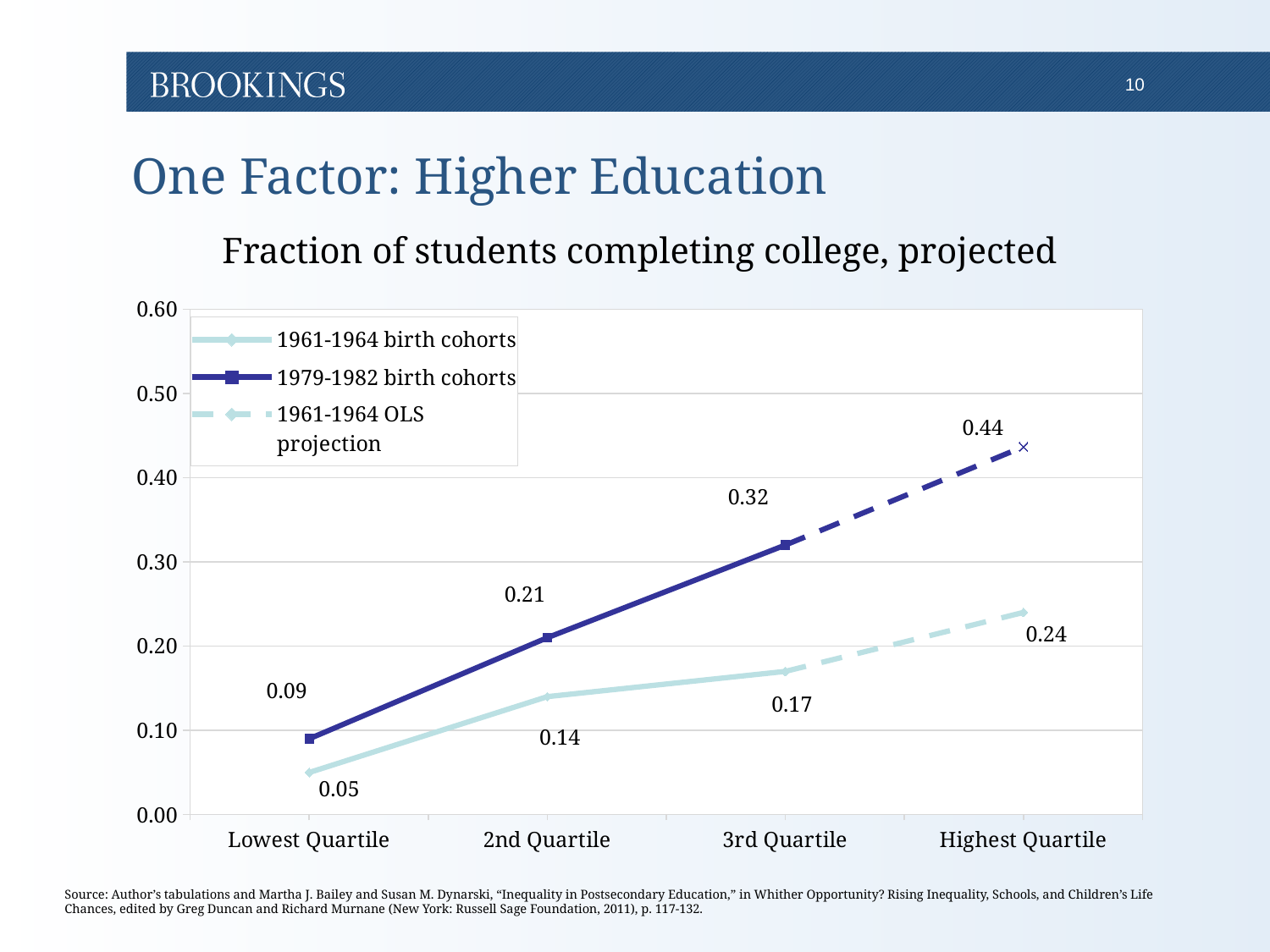
Do the values for the 1979-1982 birth cohorts rise or fall from the Lowest Quartile to the Highest Quartile? Rise At the 2nd Quartile, which series has the larger value: 1961-1964 birth cohorts or 1979-1982 birth cohorts? 1979-1982 birth cohorts What is the value for the 1979-1982 birth cohorts at the 3rd Quartile? 0.32 How many series does the legend list? 3 What is the value for the 1961-1964 birth cohorts at the Lowest Quartile? 0.05 What is the value for the 1961-1964 birth cohorts at the 2nd Quartile? 0.14 Which quartile has the lowest value for the 1961-1964 birth cohorts? Lowest Quartile What is the projected value for the 1979-1982 birth cohorts at the Highest Quartile? 0.44 What is the difference between the 1979-1982 and 1961-1964 birth cohorts at the 3rd Quartile? 0.15 How many quartile categories are shown on the x axis? 4 Which quartile has the highest value for the 1979-1982 birth cohorts? Highest Quartile What kind of chart is shown on the slide? Line chart